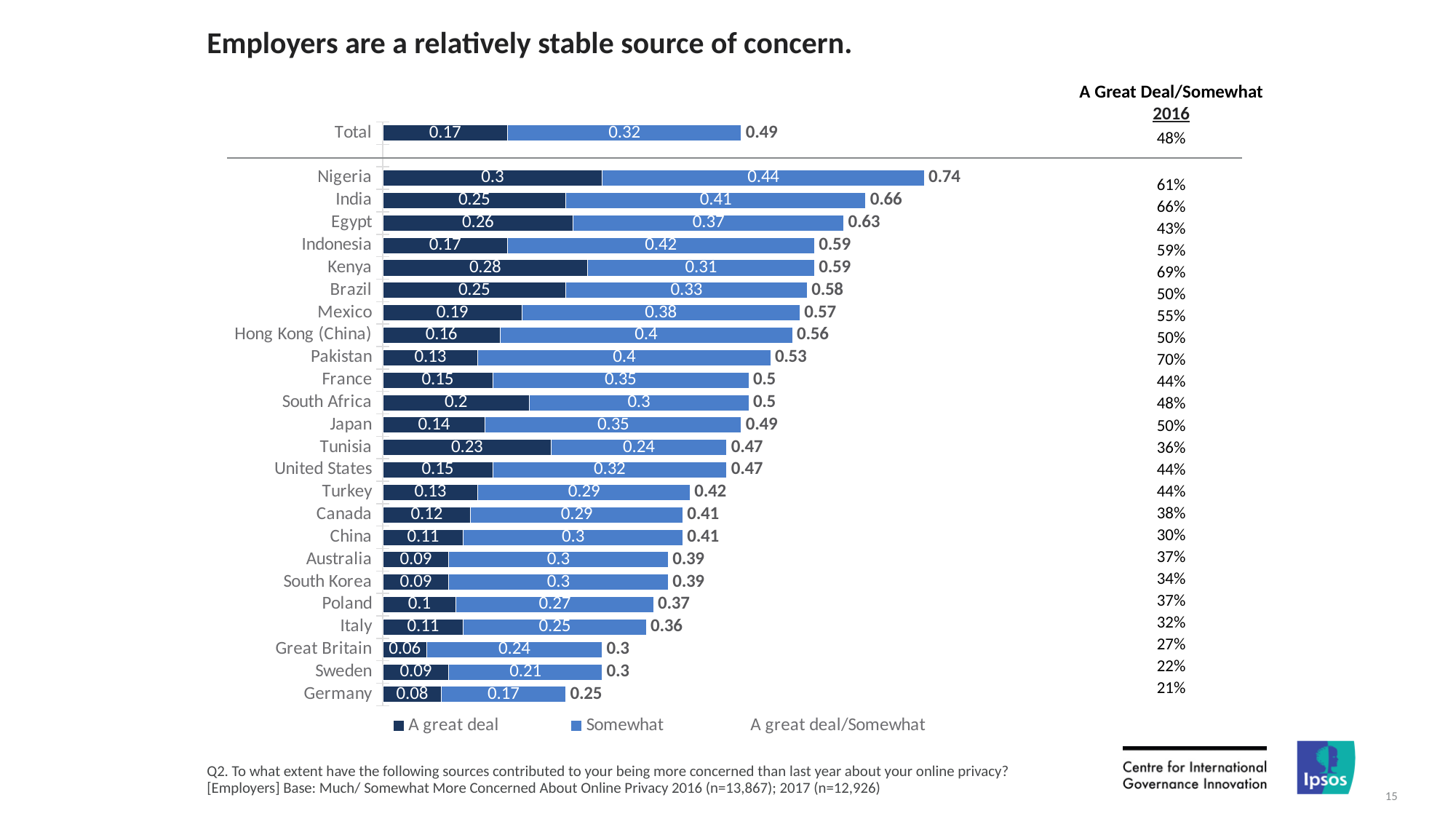
Which country has the highest combined "A great deal/Somewhat" value? Nigeria How many entries does the legend list? 3 What kind of chart is shown on the slide? Stacked bar chart What is the combined "A great deal/Somewhat" total shown for Nigeria? 0.74 How many countries (excluding Total) are listed in the chart? 24 What is the title of the slide? Employers are a relatively stable source of concern. Which has the larger "A great deal" value, Kenya or Brazil? Kenya What is the difference between the combined totals for Nigeria and Germany? 0.49 Which country has the lowest combined "A great deal/Somewhat" value? Germany What is the "A great deal" value for Nigeria? 0.3 What is the "Somewhat" value for Indonesia? 0.42 What is the 2016 "A Great Deal/Somewhat" percentage shown for Pakistan in the right-hand column? 70%